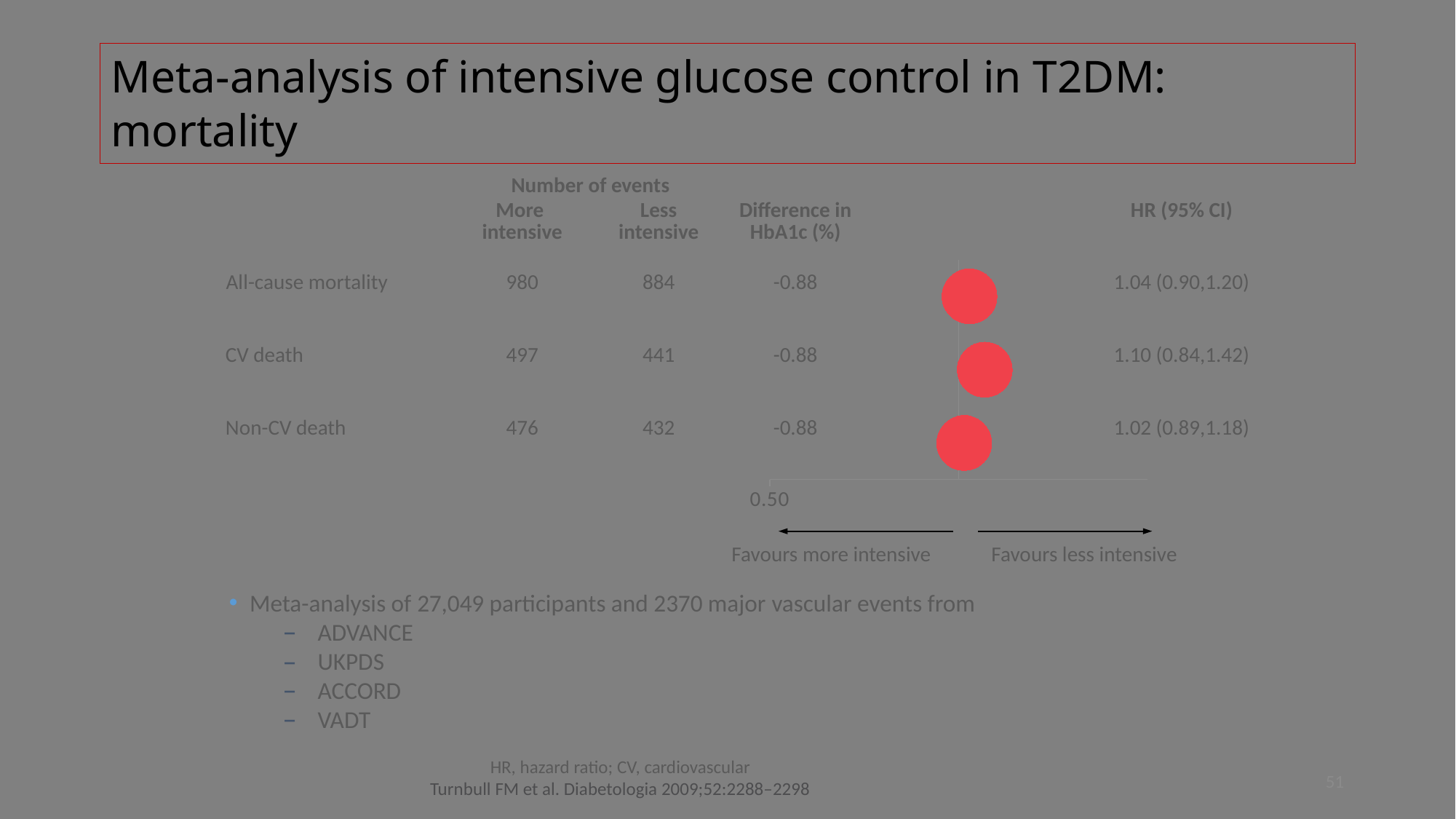
What kind of chart is shown on the slide? forest plot How many all-cause mortality events occurred in the more intensive group? 980 What is the difference in HbA1c (%) reported for CV death? -0.88 Which outcome has the lowest hazard ratio? Non-CV death Is the hazard ratio for CV death greater or less than 0.50? greater What is the HR (95% CI) for CV death? 1.10 (0.84,1.42) How many outcomes are plotted in the forest plot? 3 What is the difference in the number of all-cause mortality events between the more intensive (980) and less intensive (884) groups? 96 What is the HR (95% CI) for non-CV death? 1.02 (0.89,1.18) Which outcome has the highest hazard ratio? CV death What is the HR (95% CI) for all-cause mortality? 1.04 (0.90,1.20) What does the left-pointing arrow below the axis indicate? Favours more intensive